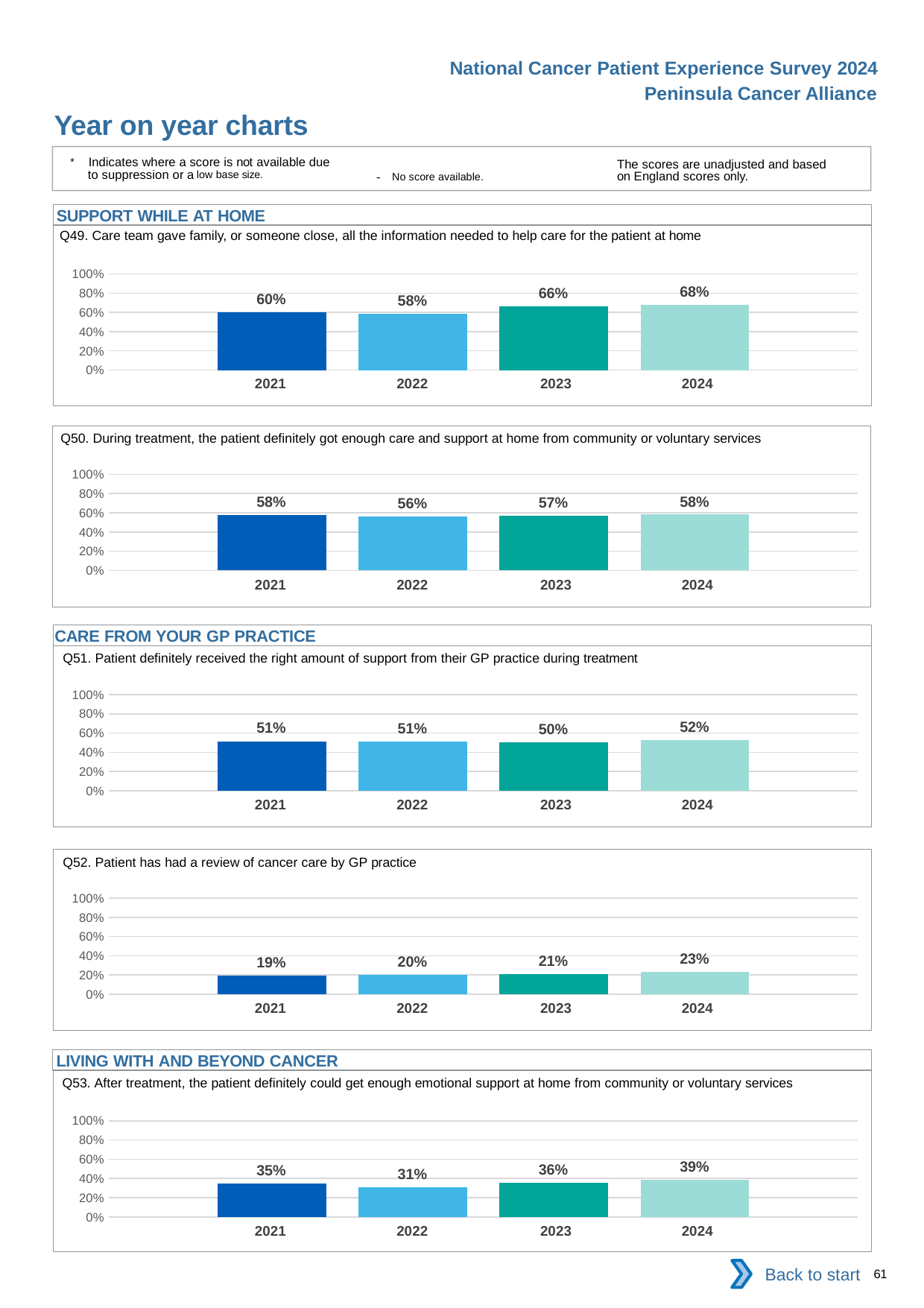
In the Q51 chart, what is the value for 2023? 50% In the Q53 chart, which year has the lowest value? 2022 In the Q52 chart, do the values rise or fall from 2021 to 2024? rise In the Q53 chart, which is larger, the value for 2021 or the value for 2023? 2023 In the Q49 chart, what is the value for 2024? 68% How many years are shown in the Q53 chart? 4 In the Q51 chart, which year has the highest value? 2024 In the Q52 chart, what is the difference between the 2024 and 2021 values? 4% In the Q49 chart, which year has the lowest value? 2022 What kind of chart is the Q49 chart? bar chart In the Q50 chart, what is the value for 2022? 56% In the Q50 chart, what is the difference between the 2021 and 2022 values? 2%